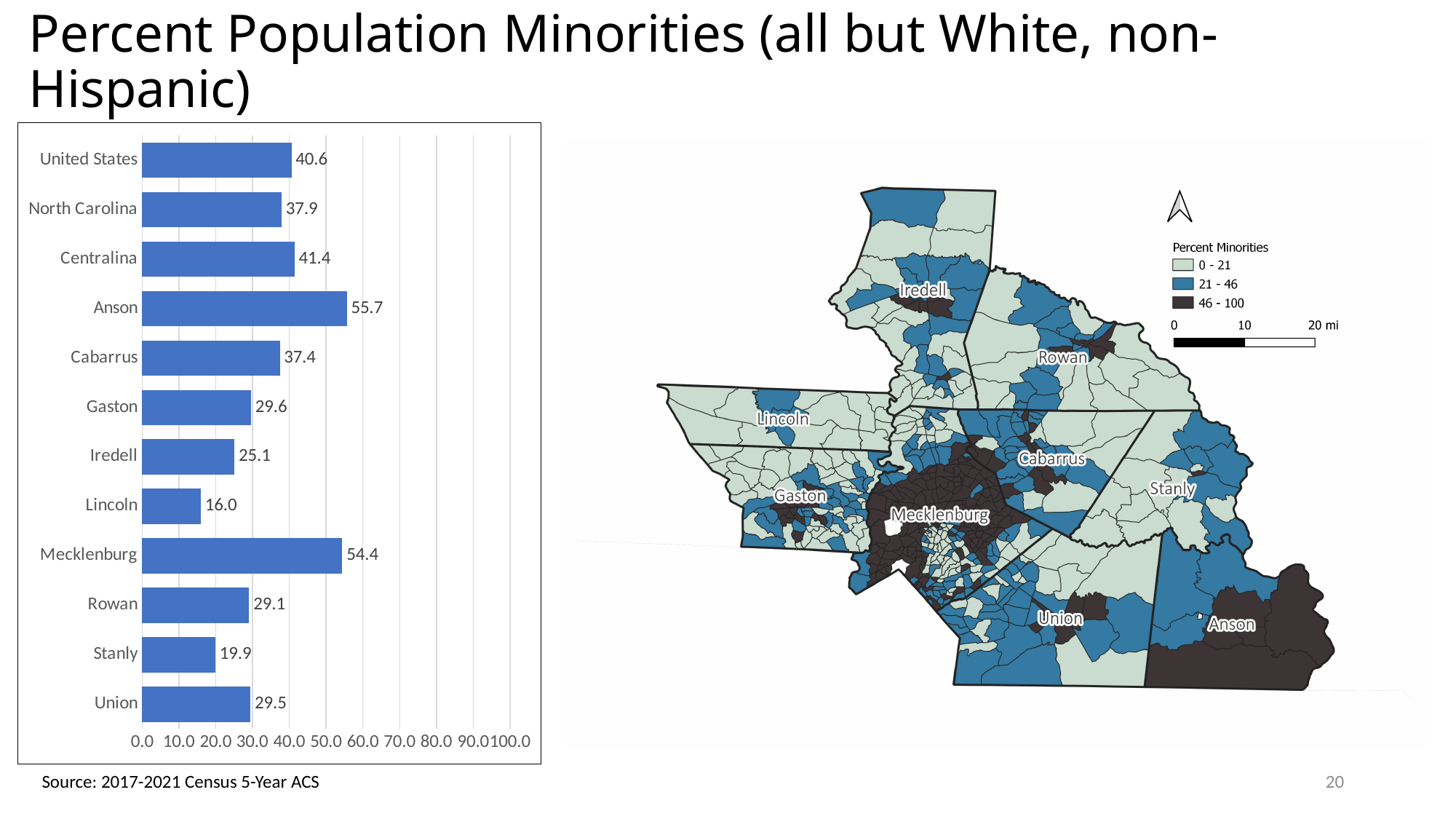
What is the value for Lincoln in the bar chart? 16.0 Is the value for Mecklenburg in the bar chart greater or less than 50.0? greater Which is larger in the bar chart, the value for Centralina or the value for Cabarrus? Centralina Which category has the lowest value in the bar chart? Lincoln Which category has the highest value in the bar chart? Anson What is the difference between the values for Anson and Mecklenburg in the bar chart? 1.3 What is the value for Anson in the bar chart? 55.7 What is the value for North Carolina in the bar chart? 37.9 What kind of chart is shown on the left of the slide? Bar chart What is the difference between the values for United States and Stanly in the bar chart? 20.7 What is the maximum value shown on the x axis of the bar chart? 100.0 How many categories are shown in the bar chart? 12